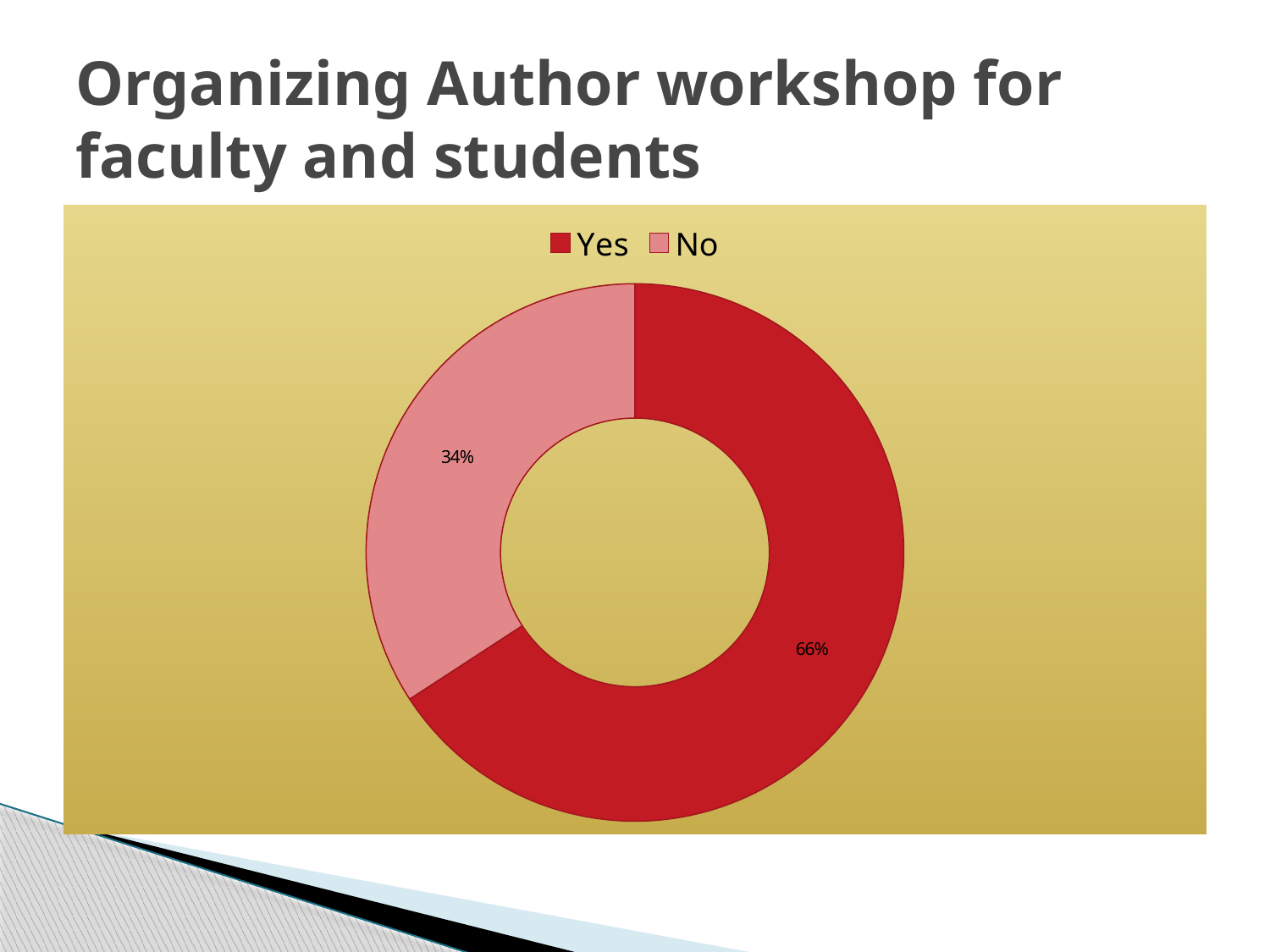
What is the difference in percentage points between the "Yes" and "No" shares? 32 What kind of chart is shown on the slide? Doughnut (pie) chart What percentage of responses are "No"? 34% Which category has the largest share of the chart? Yes What percentage of responses are "Yes"? 66% What is the total of the two percentages shown on the chart? 100% What share of the chart does the "No" slice represent? 34% How many categories does the chart show? 2 Which is larger, the "Yes" share or the "No" share? Yes What are the two entries listed in the legend? Yes and No What colour is the "Yes" slice? Red Which category has the smallest share of the chart? No